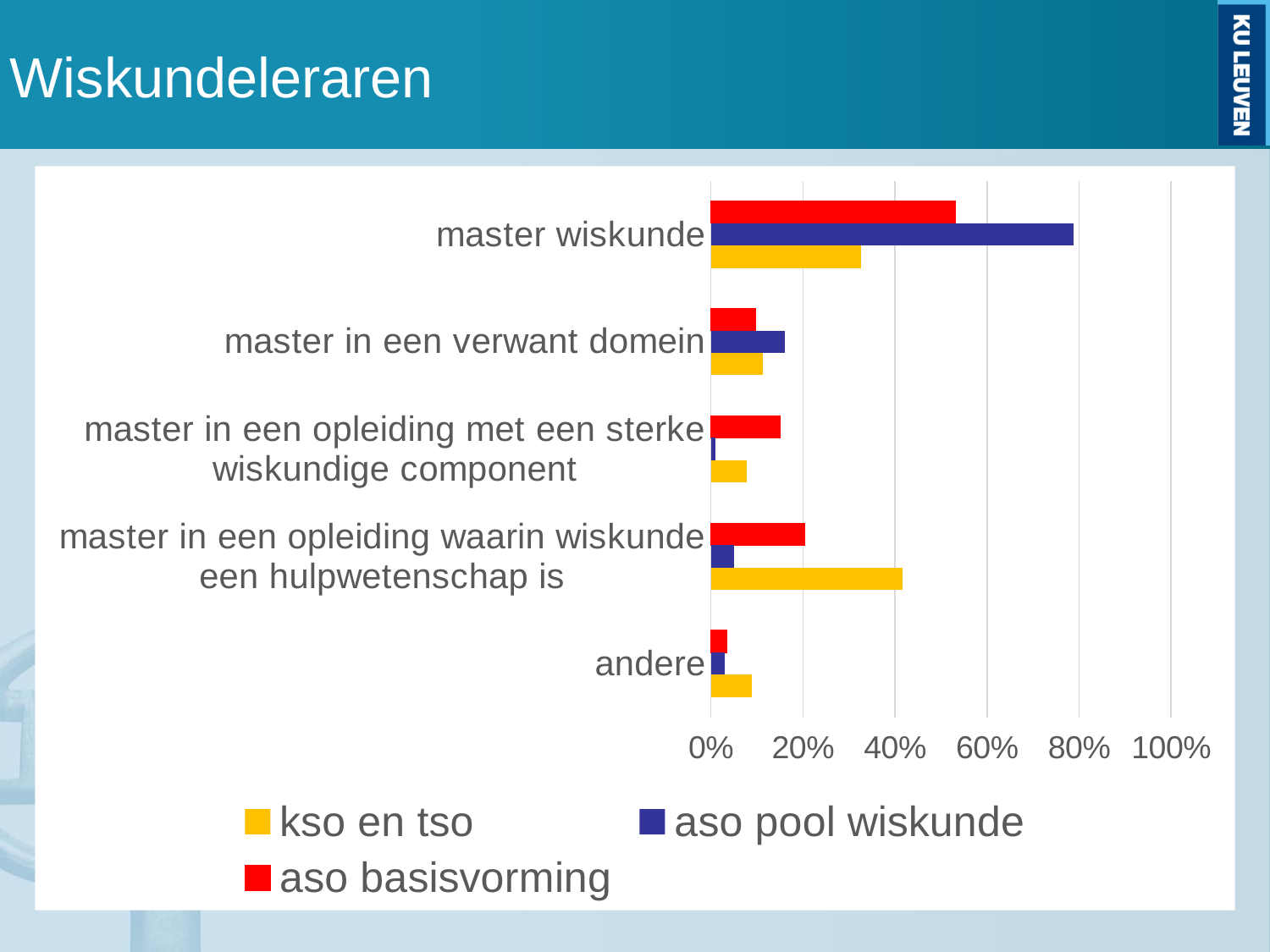
Which category has the highest value for the 'aso pool wiskunde' series? master wiskunde What kind of chart is shown on the slide? bar chart How many categories are shown on the vertical axis of the chart? 5 Which colour represents the 'aso basisvorming' series in the chart? red Is the value for 'kso en tso' in the 'master wiskunde' category greater or less than 40%? less Is the value for 'kso en tso' in the 'master in een opleiding waarin wiskunde een hulpwetenschap is' category greater or less than 20%? greater Which category has the highest value for the 'kso en tso' series? master in een opleiding waarin wiskunde een hulpwetenschap is Is the value for 'aso pool wiskunde' in the 'master wiskunde' category greater or less than 60%? greater How many series does the legend list? 3 In the 'master in een opleiding waarin wiskunde een hulpwetenschap is' category, which series has the larger value: 'kso en tso' or 'aso pool wiskunde'? kso en tso In the 'master wiskunde' category, which series has the larger value: 'aso pool wiskunde' or 'aso basisvorming'? aso pool wiskunde